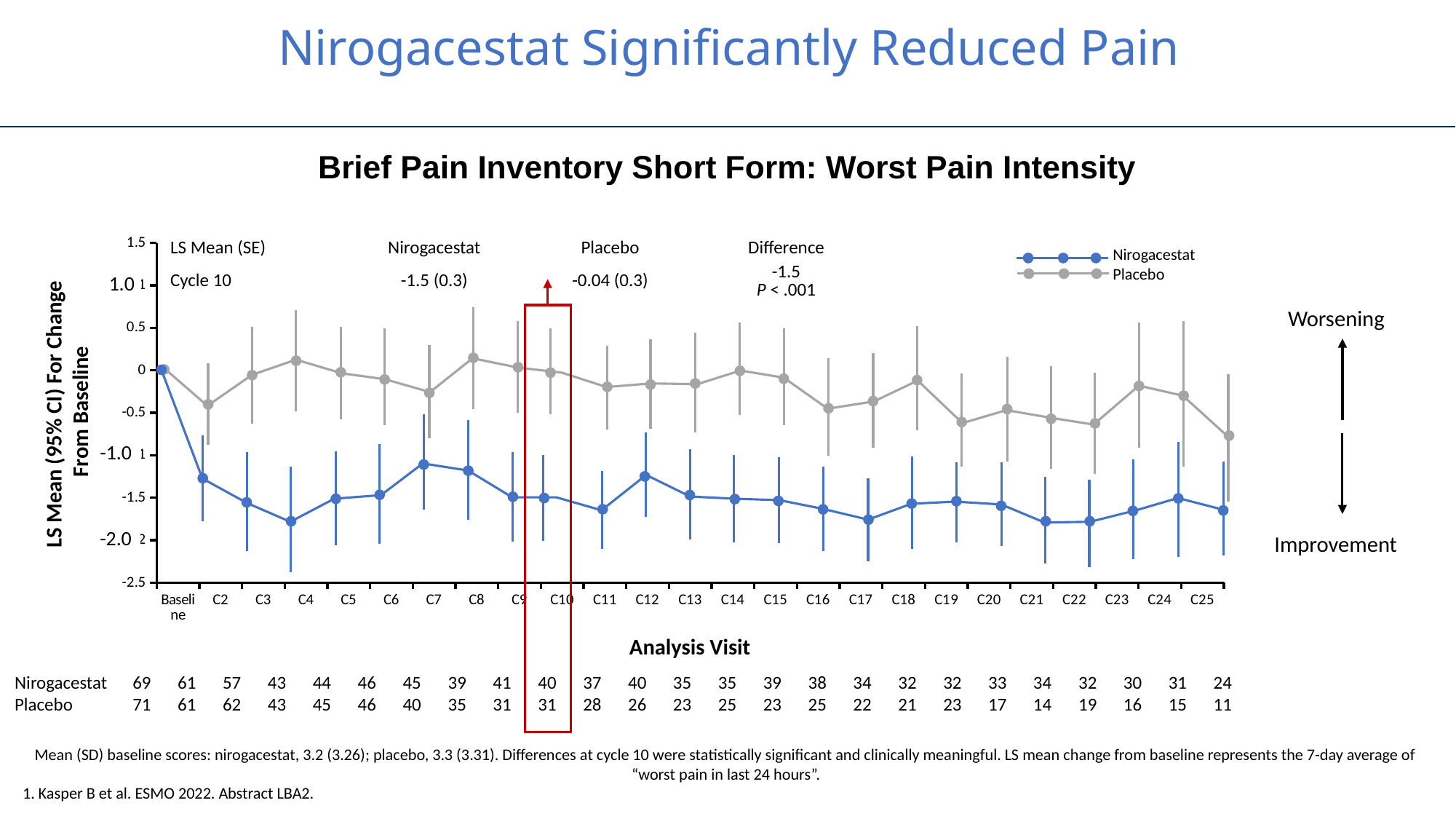
At C10, which series has the higher LS mean change from baseline, Nirogacestat or Placebo? Placebo How many analysis visits are shown along the x axis (including Baseline)? 25 How many series does the legend list? 2 Is the Nirogacestat value at C4 greater or less than -1.5? less Does the Nirogacestat line rise or fall from Baseline to C2? Fall What is the LS Mean (SE) for Nirogacestat at Cycle 10? -1.5 (0.3) How many Nirogacestat patients are listed at C10 in the table below the chart? 40 What is the title of the chart? Brief Pain Inventory Short Form: Worst Pain Intensity What is the difference between Nirogacestat and Placebo at Cycle 10? -1.5 Is the Placebo value at C8 greater or less than 0? greater What is the LS Mean (SE) for Placebo at Cycle 10? -0.04 (0.3) What kind of chart is shown on the slide? Line chart